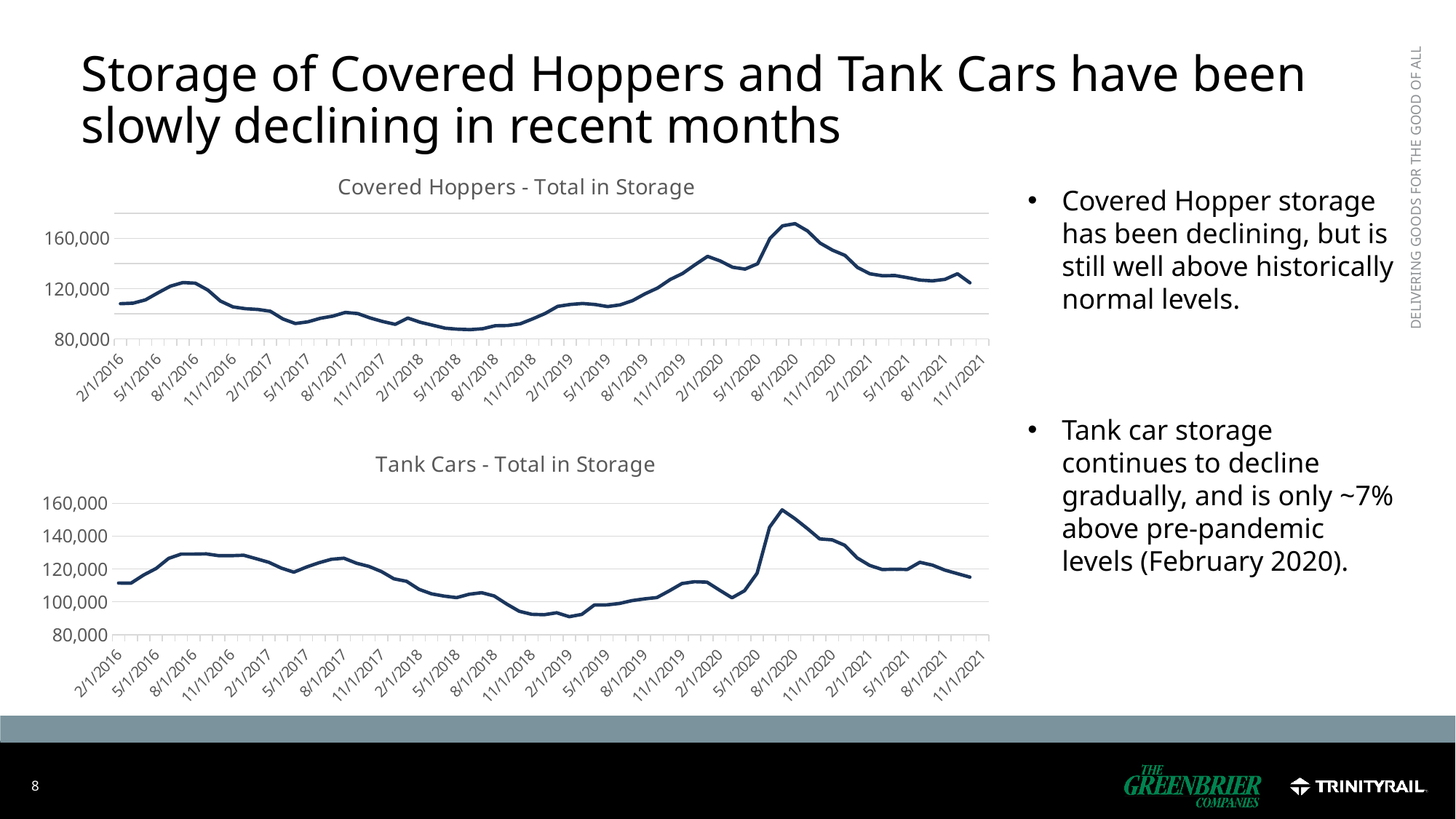
In the "Covered Hoppers - Total in Storage" chart, around which date does the line reach its highest point? 8/1/2020 In the "Covered Hoppers - Total in Storage" chart, is the value at 8/1/2020 greater or less than 160,000? greater In the "Covered Hoppers - Total in Storage" chart, is the value at 5/1/2018 greater or less than 120,000? less In the "Tank Cars - Total in Storage" chart, is the value at 8/1/2020 greater or less than 140,000? greater How many charts are shown on the slide? 2 What is the title of the lower chart on the slide? Tank Cars - Total in Storage In the "Tank Cars - Total in Storage" chart, which is larger, the value at 8/1/2016 or the value at 11/1/2018? 8/1/2016 In the "Tank Cars - Total in Storage" chart, do the values rise or fall from 8/1/2020 to 11/1/2021? fall What kind of chart is the "Covered Hoppers - Total in Storage" chart? line chart